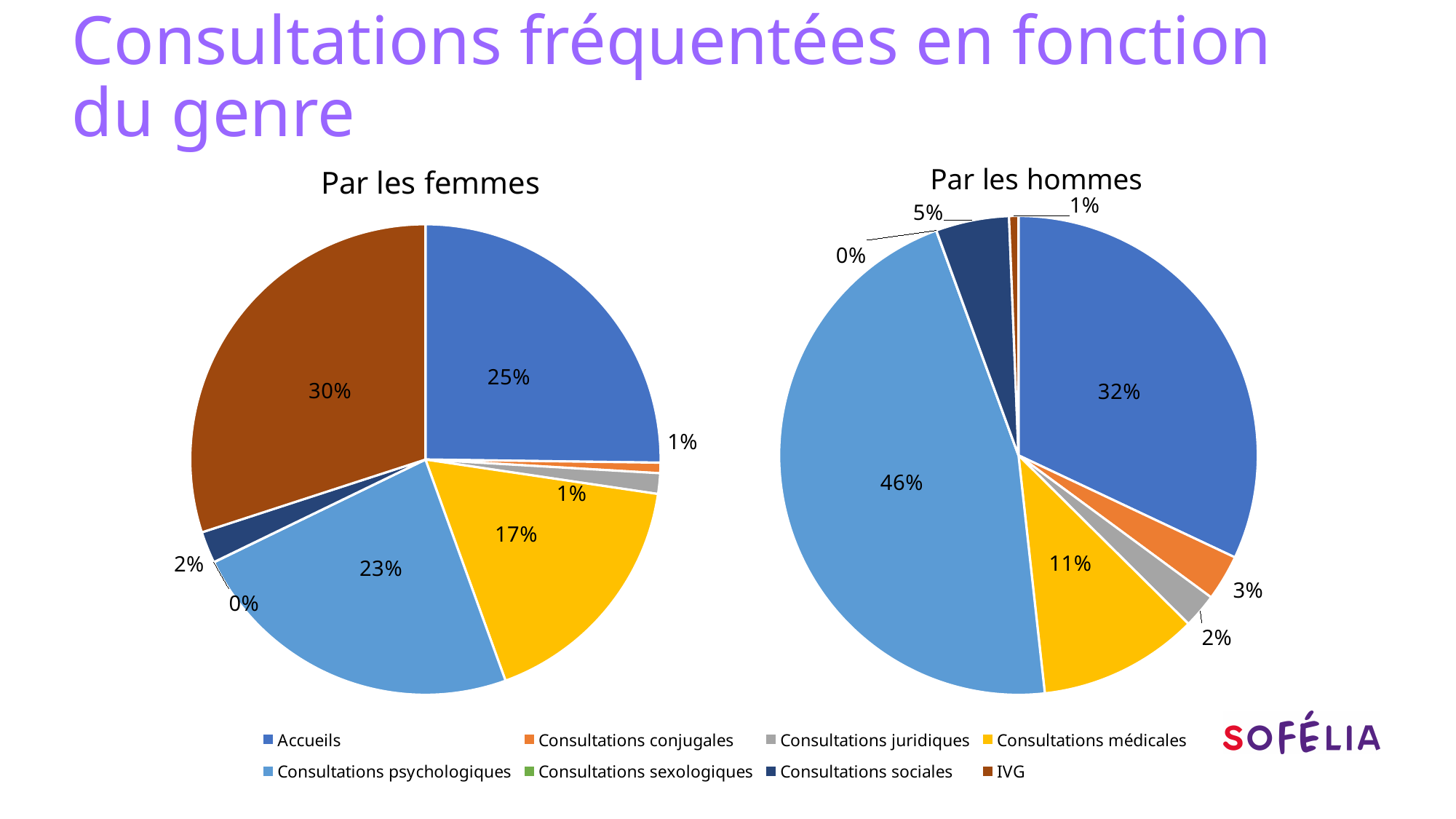
Which is larger: the Accueils share in the 'Par les femmes' chart or the Accueils share in the 'Par les hommes' chart? Par les hommes In the 'Par les femmes' chart, which category has the largest share? IVG How many categories does the legend list? 8 In the 'Par les femmes' chart, what share is IVG? 30% In the 'Par les femmes' chart, what share is Consultations médicales? 17% What is the title of the chart on the right? Par les hommes In the 'Par les hommes' chart, what is the difference between the Accueils share and the Consultations médicales share? 21% In the 'Par les hommes' chart, which category has the largest share? Consultations psychologiques In the 'Par les hommes' chart, what share is Consultations sociales? 5% What type of chart is used on this slide? Pie chart In the 'Par les hommes' chart, what share is Consultations psychologiques? 46% In the 'Par les femmes' chart, what is the difference between the IVG share and the Accueils share? 5%